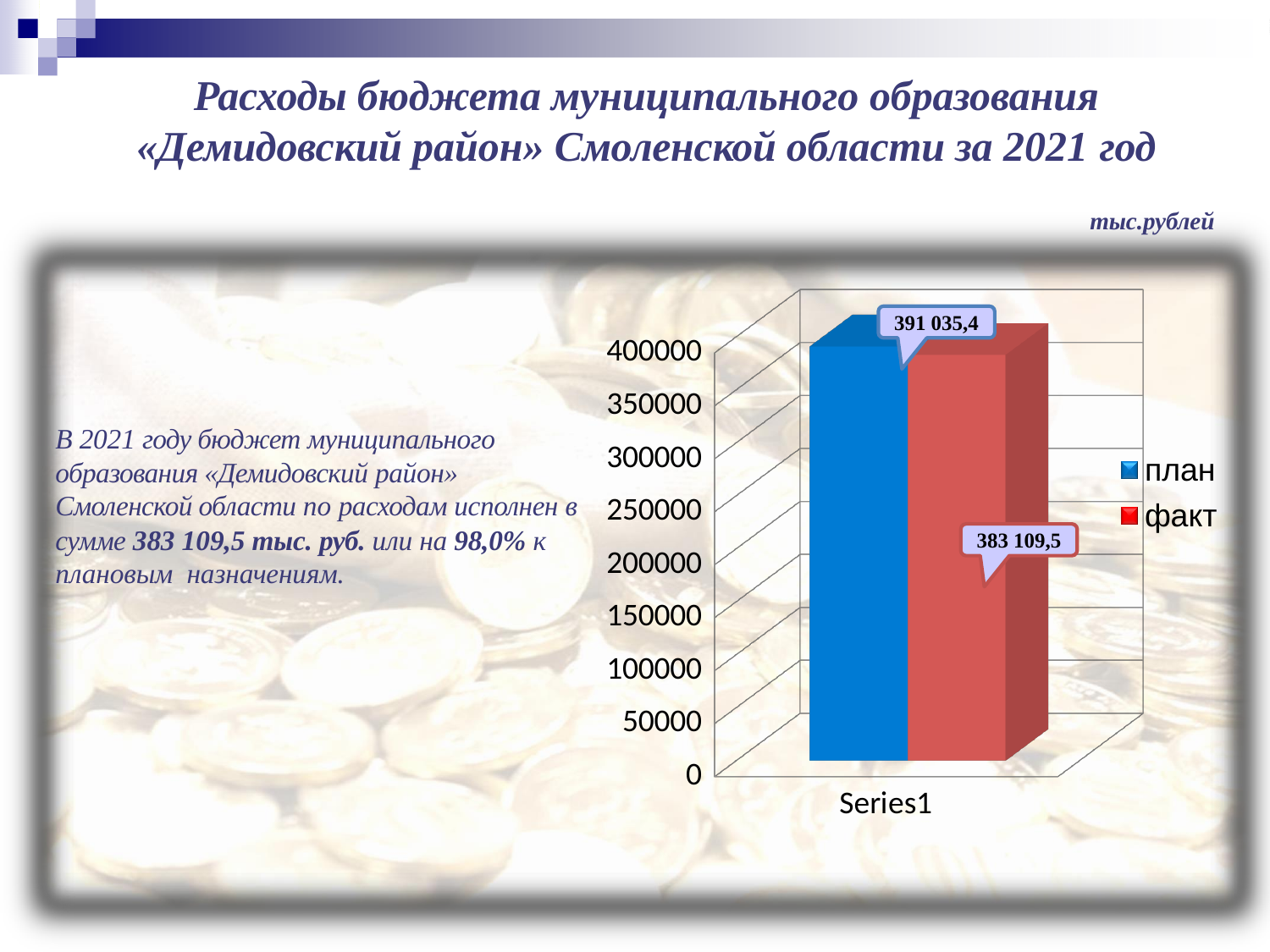
How many categories are shown on the x axis of the chart? 1 What is the value of the факт series on the chart? 383 109,5 What is the value of the план series on the chart? 391 035,4 Which series has the higher value, план or факт? план What is the category label shown on the x axis of the chart? Series1 What is the difference between the план value and the факт value? 7 925,9 Is the value for факт greater or less than 350000? greater What kind of chart is shown on the slide? bar chart Which series has the lowest value on the chart? факт Is the value for план greater or less than 400000? less How many series does the legend list? 2 What colour is the факт series in the chart? red